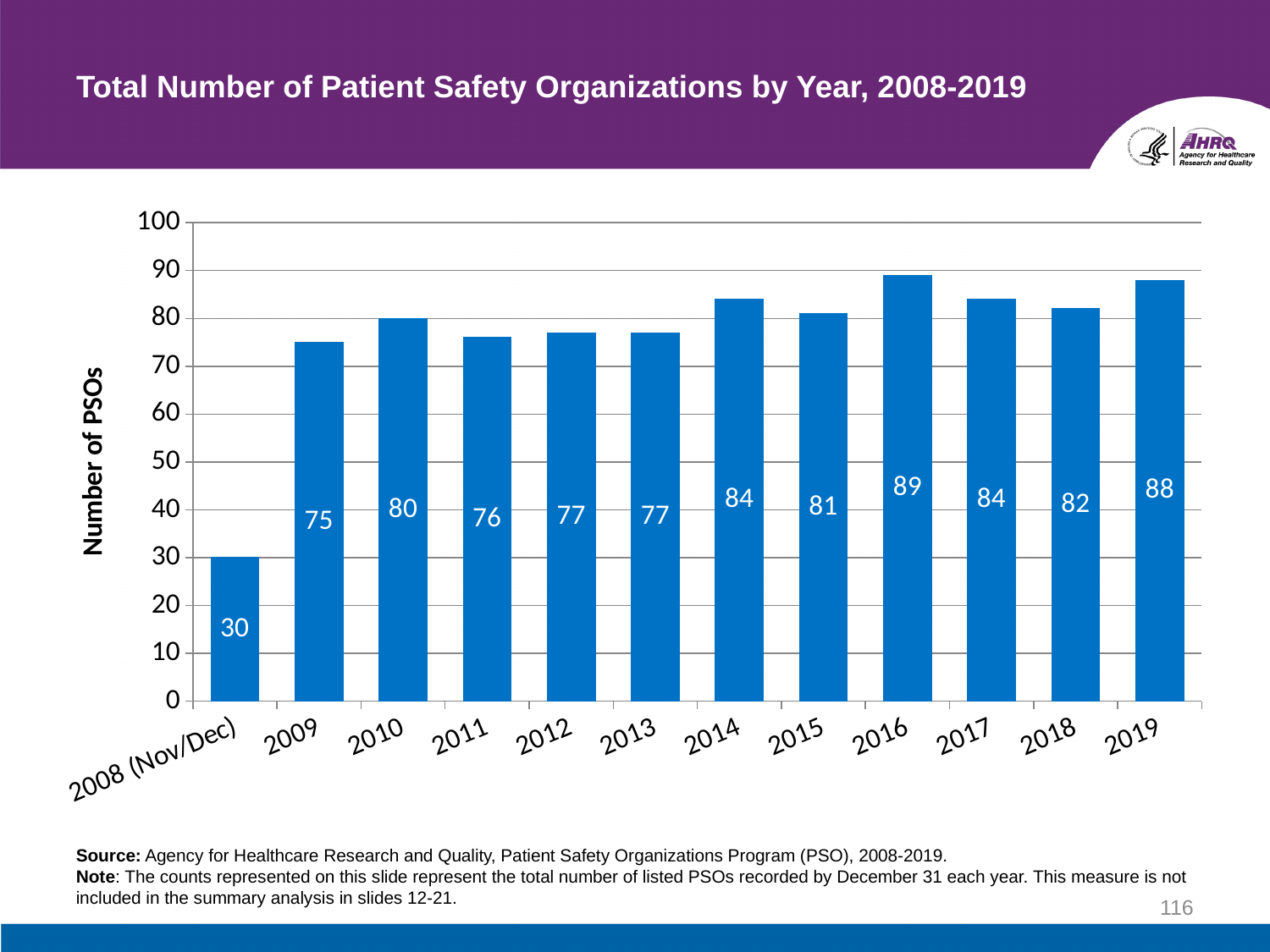
Is the number of PSOs in 2014 greater or less than 80? greater What is the difference in the number of PSOs between 2009 and 2008 (Nov/Dec)? 45 What is the number of PSOs in 2016? 89 Which year has the highest number of PSOs? 2016 What is the number of PSOs in 2008 (Nov/Dec)? 30 Which year has more PSOs, 2010 or 2015? 2015 How many years are shown on the x axis? 12 What kind of chart is shown on the slide? Bar chart Which year has the lowest number of PSOs? 2008 (Nov/Dec) What is the difference in the number of PSOs between 2016 and 2018? 7 What is the number of PSOs in 2019? 88 What is the label of the y axis? Number of PSOs